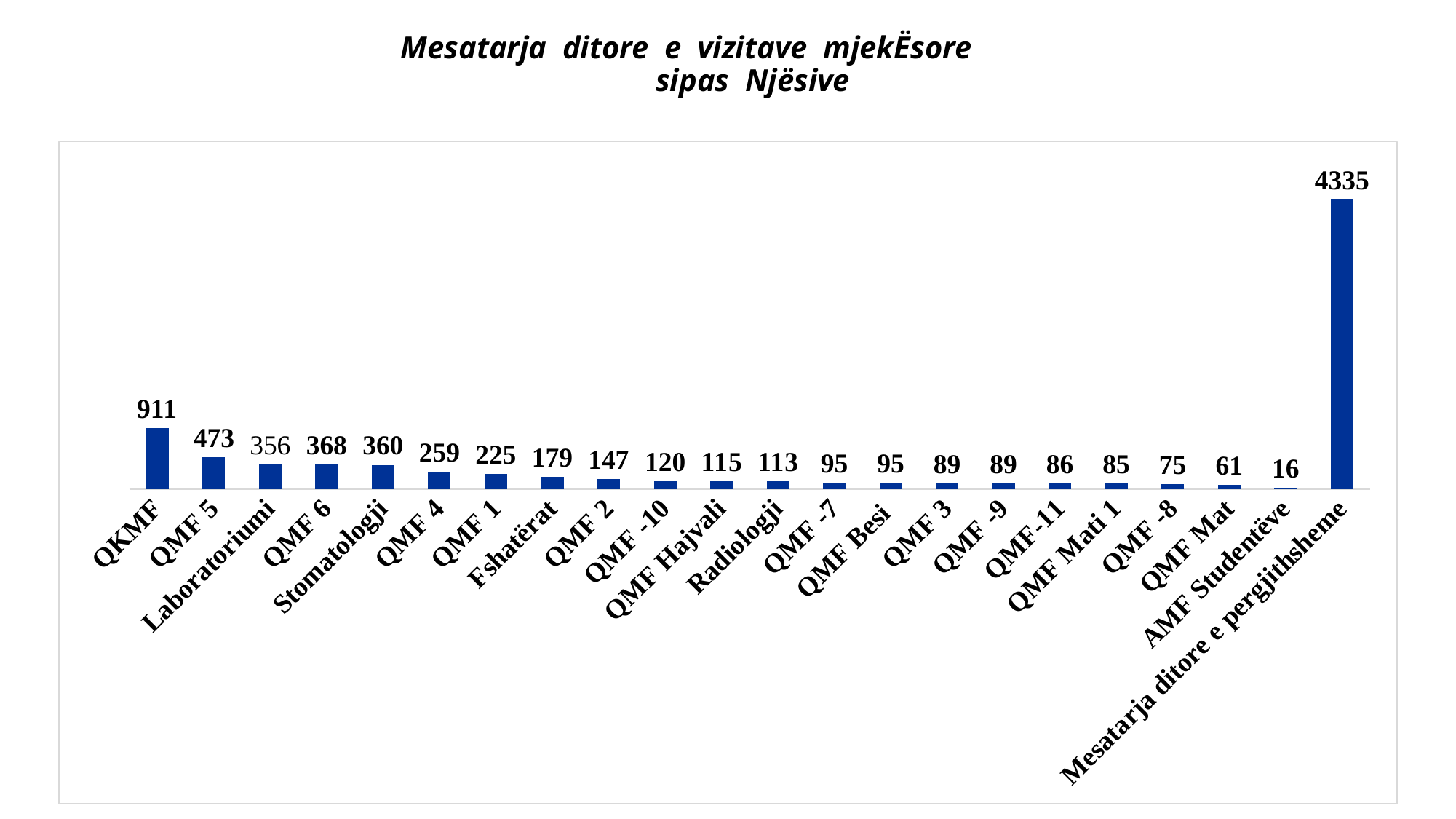
What is the value for QKMF? 911 What kind of chart is shown on the slide? Bar chart What is the value for Stomatologji? 360 What is the value for Mesatarja ditore e pergjithsheme? 4335 What is the value for AMF Studentëve? 16 Which category has the lowest value? AMF Studentëve What is the difference between the values for QKMF and QMF 5? 438 What is the difference between the values for QMF 6 and Laboratoriumi? 12 What is the title of the chart? Mesatarja ditore e vizitave mjekËsore sipas Njësive How many categories are shown on the chart? 22 Which is larger, the value for QMF 4 or the value for QMF 1? QMF 4 Which category has the highest value? Mesatarja ditore e pergjithsheme